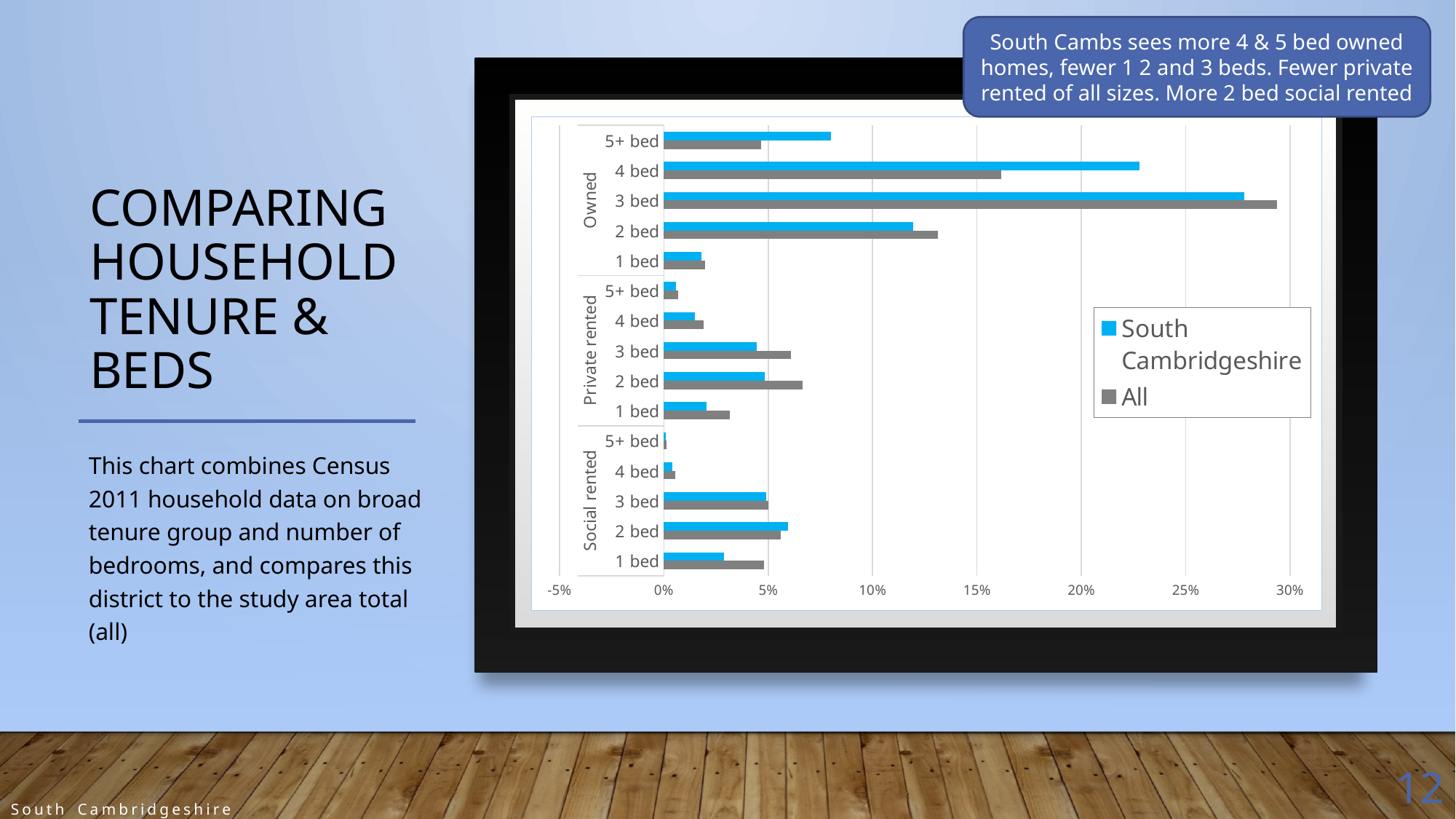
Is the All value for Owned 3 bed greater or less than 25%? greater Is the South Cambridgeshire value for Owned 5+ bed greater or less than 10%? less Which tenure group and bedroom category has the lowest South Cambridgeshire value? Social rented, 5+ bed For Private rented 2 bed, which series has the larger value, South Cambridgeshire or All? All How many bedroom categories are plotted in the chart in total across all three tenure groups? 15 For Owned 4 bed, which series has the larger value, South Cambridgeshire or All? South Cambridgeshire Which tenure group and bedroom category has the highest South Cambridgeshire value? Owned, 3 bed What kind of chart is shown on the slide? Bar chart What are the two series named in the chart legend? South Cambridgeshire and All Is the South Cambridgeshire value for Owned 4 bed greater or less than 20%? greater How many series does the chart legend list? 2 Which colour represents the All series in the chart? Grey